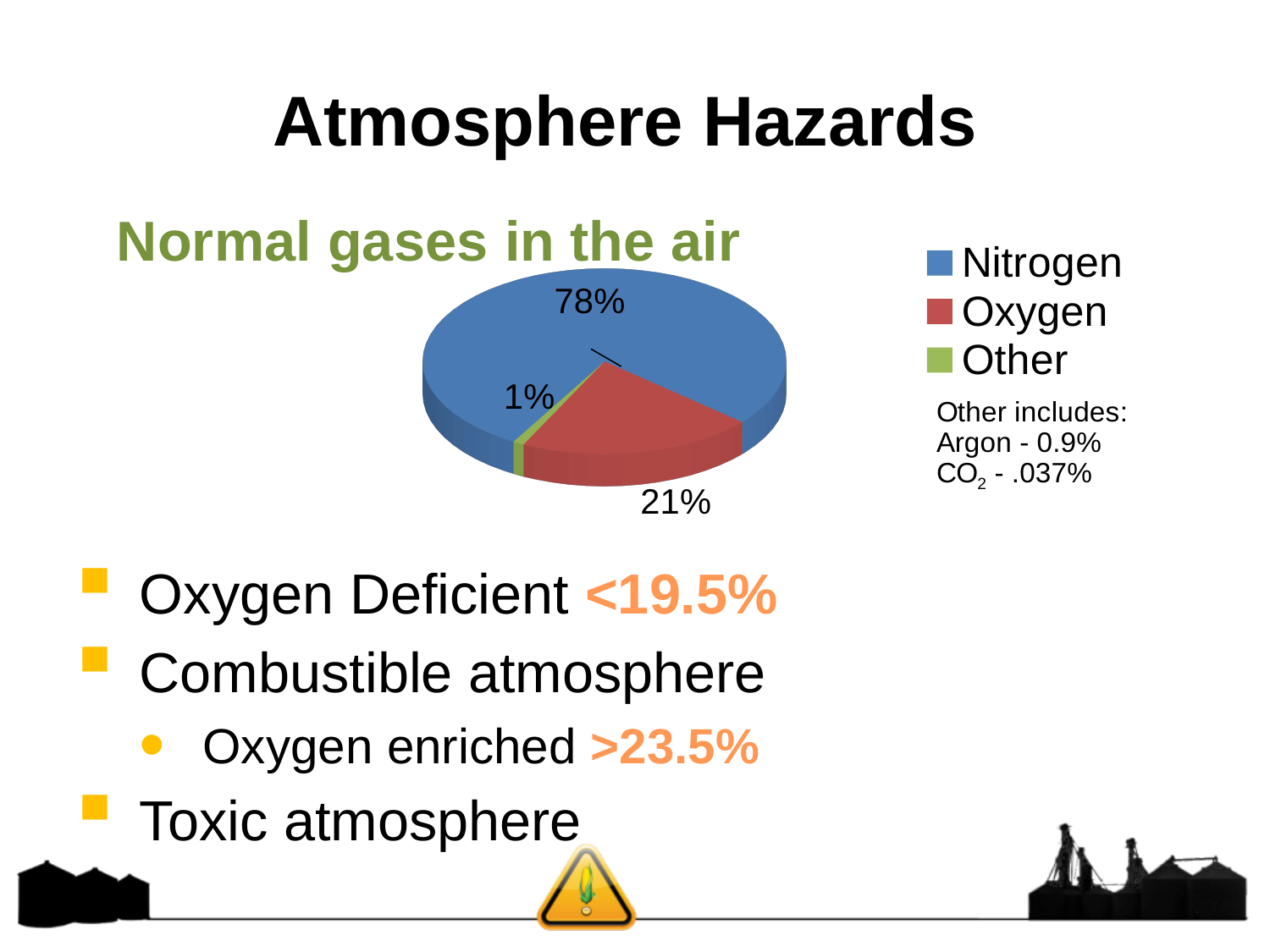
Which colour represents Oxygen in the pie chart? Red How many entries does the pie chart legend list? 3 Which gas has the largest slice in the pie chart? Nitrogen What is the difference in percentage points between the Nitrogen and Oxygen slices? 57 What type of chart is shown on the slide? Pie chart How many slices does the pie chart have? 3 Which gas has the smallest slice in the pie chart? Other What is the title of the chart on the slide? Normal gases in the air Which is larger in the pie chart, the Oxygen slice or the Other slice? Oxygen What percentage of the air is Oxygen according to the pie chart? 21% What percentage of the air is labelled Other in the pie chart? 1% What percentage of the air is Nitrogen according to the pie chart? 78%